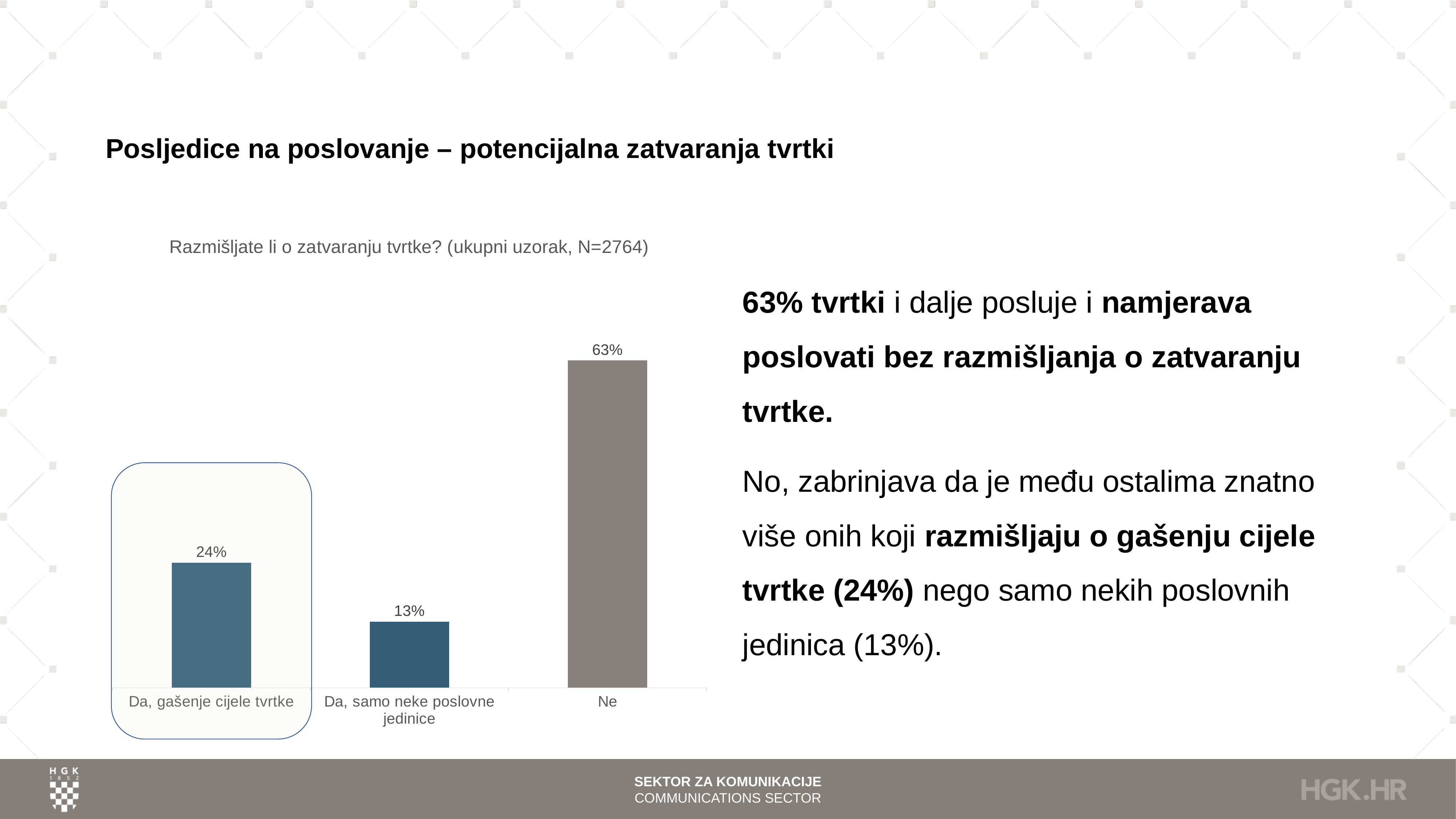
What is the difference between the values for "Da, gašenje cijele tvrtke" and "Da, samo neke poslovne jedinice"? 11% What is the value for "Da, gašenje cijele tvrtke"? 24% What is the difference between the values for "Ne" and "Da, gašenje cijele tvrtke"? 39% How many categories are shown in the chart? 3 Which category has the highest value? Ne What kind of chart is shown on the slide? Bar chart Which category has the lowest value? Da, samo neke poslovne jedinice What is the value for "Ne"? 63% Which category's bar is highlighted with a rounded outline box? Da, gašenje cijele tvrtke What is the title of the chart? Razmišljate li o zatvaranju tvrtke? (ukupni uzorak, N=2764) What is the value for "Da, samo neke poslovne jedinice"? 13% Which is larger, the value for "Da, gašenje cijele tvrtke" or for "Da, samo neke poslovne jedinice"? Da, gašenje cijele tvrtke